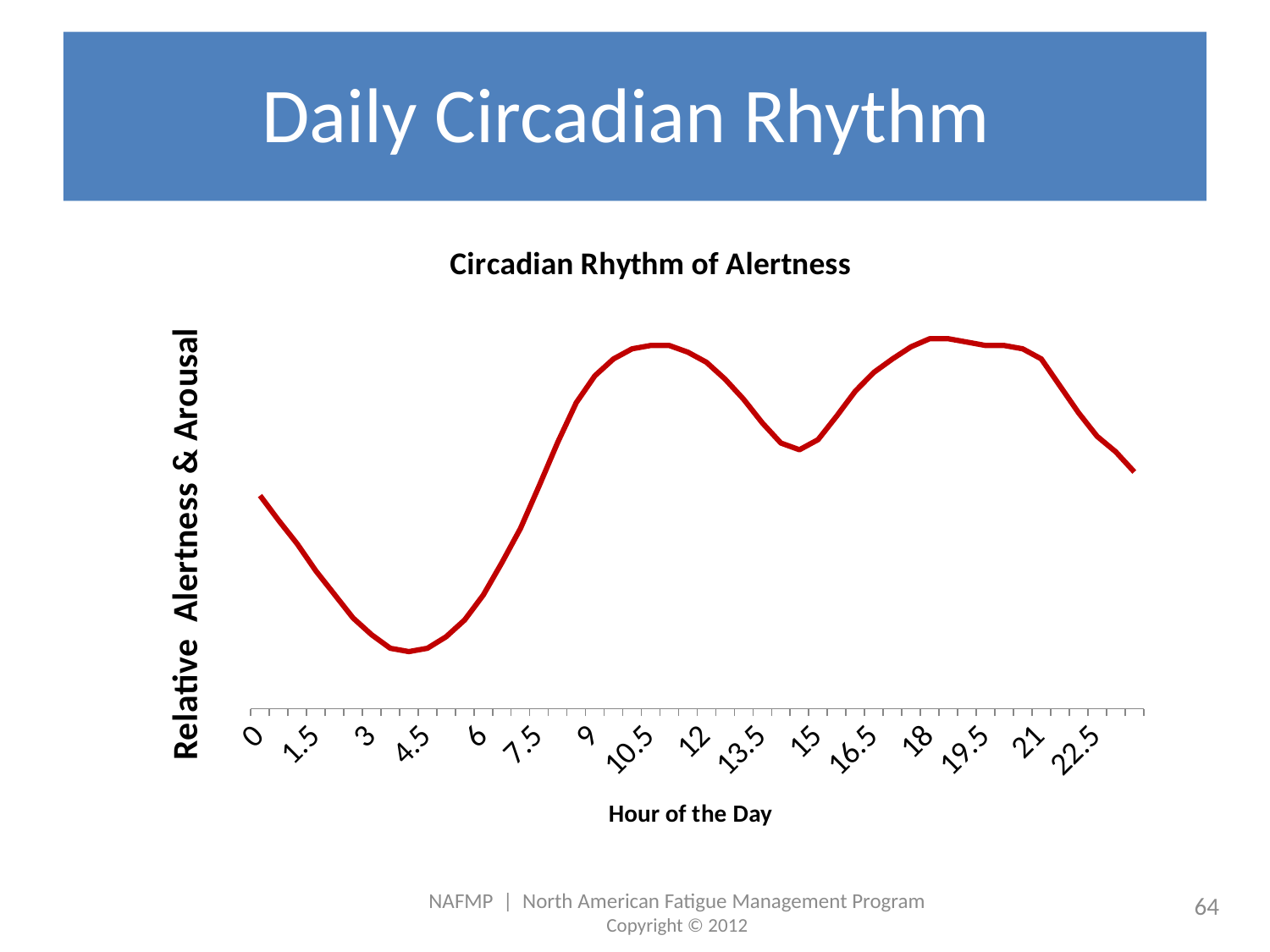
Does the line rise or fall between hour 4.5 and hour 10.5? Rise Does the line rise or fall between hour 21 and hour 22.5? Fall Which is larger, the alertness value at hour 10.5 or at hour 4.5? Hour 10.5 What is the title of the chart? Circadian Rhythm of Alertness Which is larger, the alertness value at hour 15 or at hour 0? Hour 15 How many hour labels are shown along the x axis? 16 What kind of chart is shown on the slide? Line chart Does the line rise or fall between hour 0 and hour 4.5? Fall What is the label of the x axis? Hour of the Day